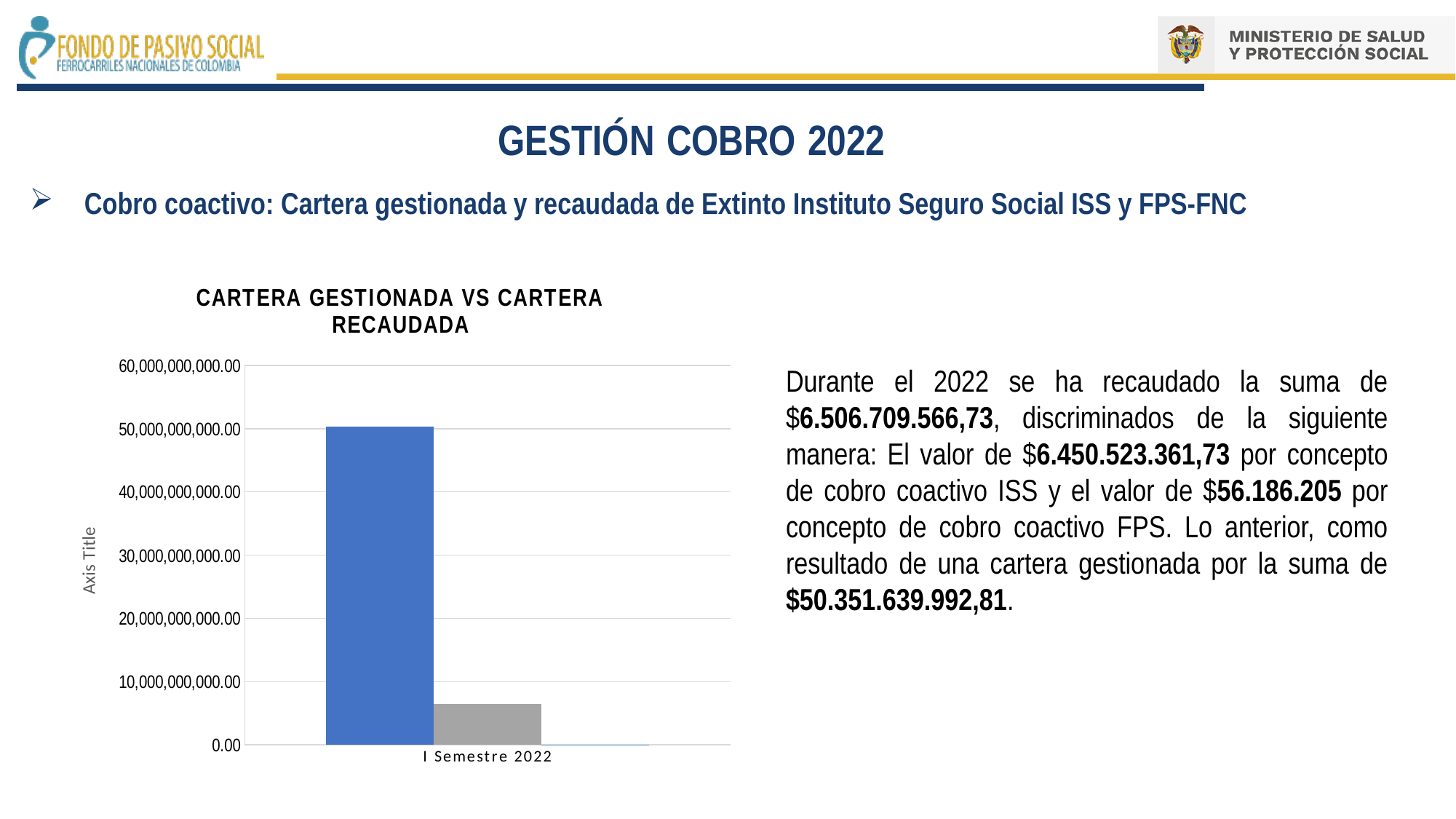
What is the highest value shown on the y axis of the chart? 60,000,000,000.00 Is the value of the blue bar greater or less than 60,000,000,000.00? less Which bar is taller, the blue bar or the gray bar? the blue bar What is the category label on the x axis of the chart? I Semestre 2022 Is the value of the gray bar greater or less than 10,000,000,000.00? less What colour is the tallest bar in the chart? blue Is the value of the blue bar greater or less than 40,000,000,000.00? greater What is the title of the chart? CARTERA GESTIONADA VS CARTERA RECAUDADA How many categories are shown on the x axis of the chart? 1 What kind of chart is shown on the slide? bar chart